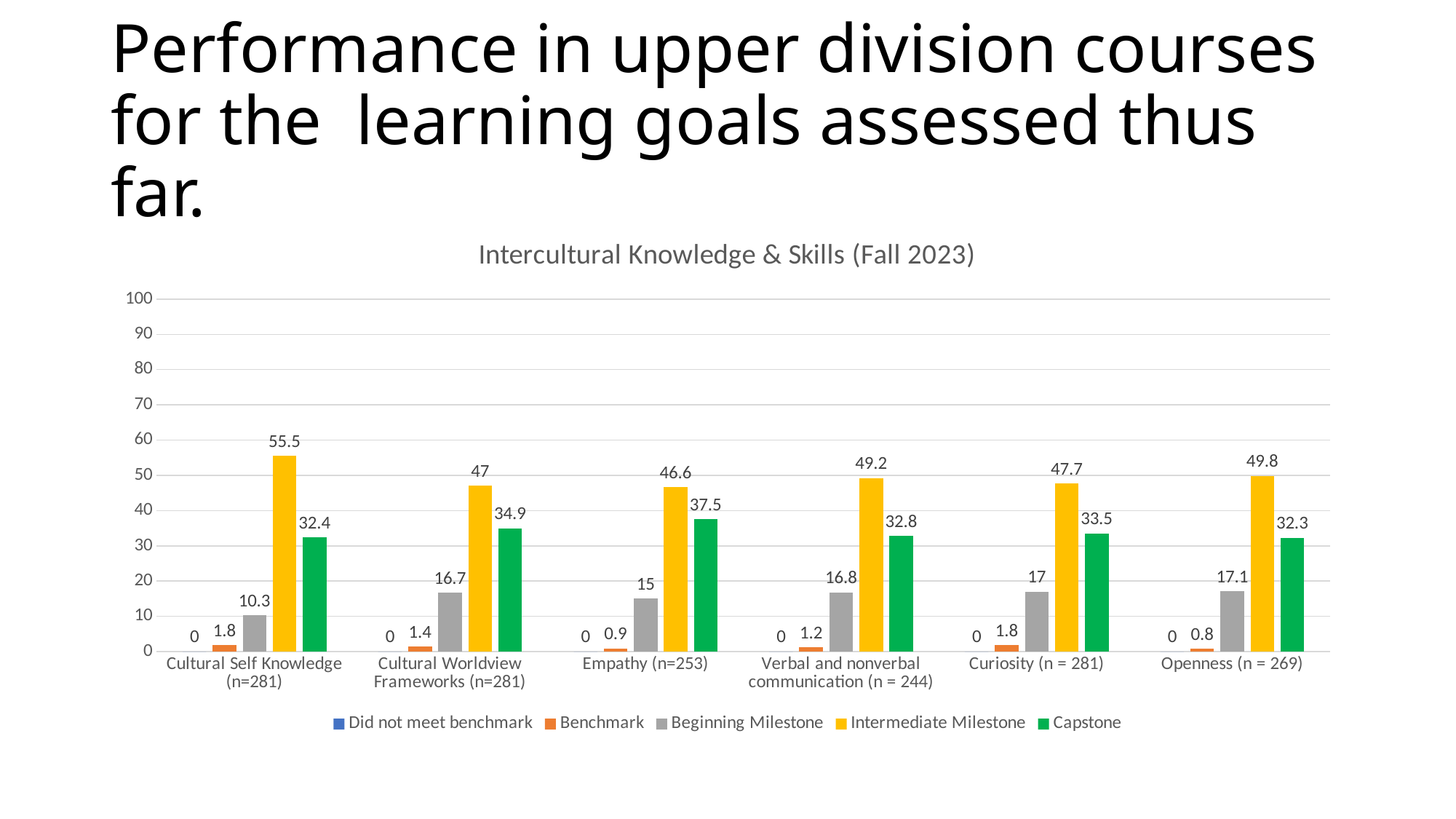
What is the Intermediate Milestone value for Cultural Self Knowledge (n=281)? 55.5 What is the Benchmark value for Verbal and nonverbal communication (n = 244)? 1.2 How many series does the legend list? 5 Which category has the lowest Beginning Milestone value? Cultural Self Knowledge (n=281) What is the difference between the Intermediate Milestone and Capstone values for Curiosity (n = 281)? 14.2 What is the Capstone value for Empathy (n=253)? 37.5 What kind of chart is shown? Bar chart What is the title of the chart? Intercultural Knowledge & Skills (Fall 2023) Which category has the highest Intermediate Milestone value? Cultural Self Knowledge (n=281) How many categories are shown on the x axis? 6 What is the Beginning Milestone value for Openness (n = 269)? 17.1 Which is larger, the Capstone value for Empathy (n=253) or the Capstone value for Cultural Worldview Frameworks (n=281)? Empathy (n=253)